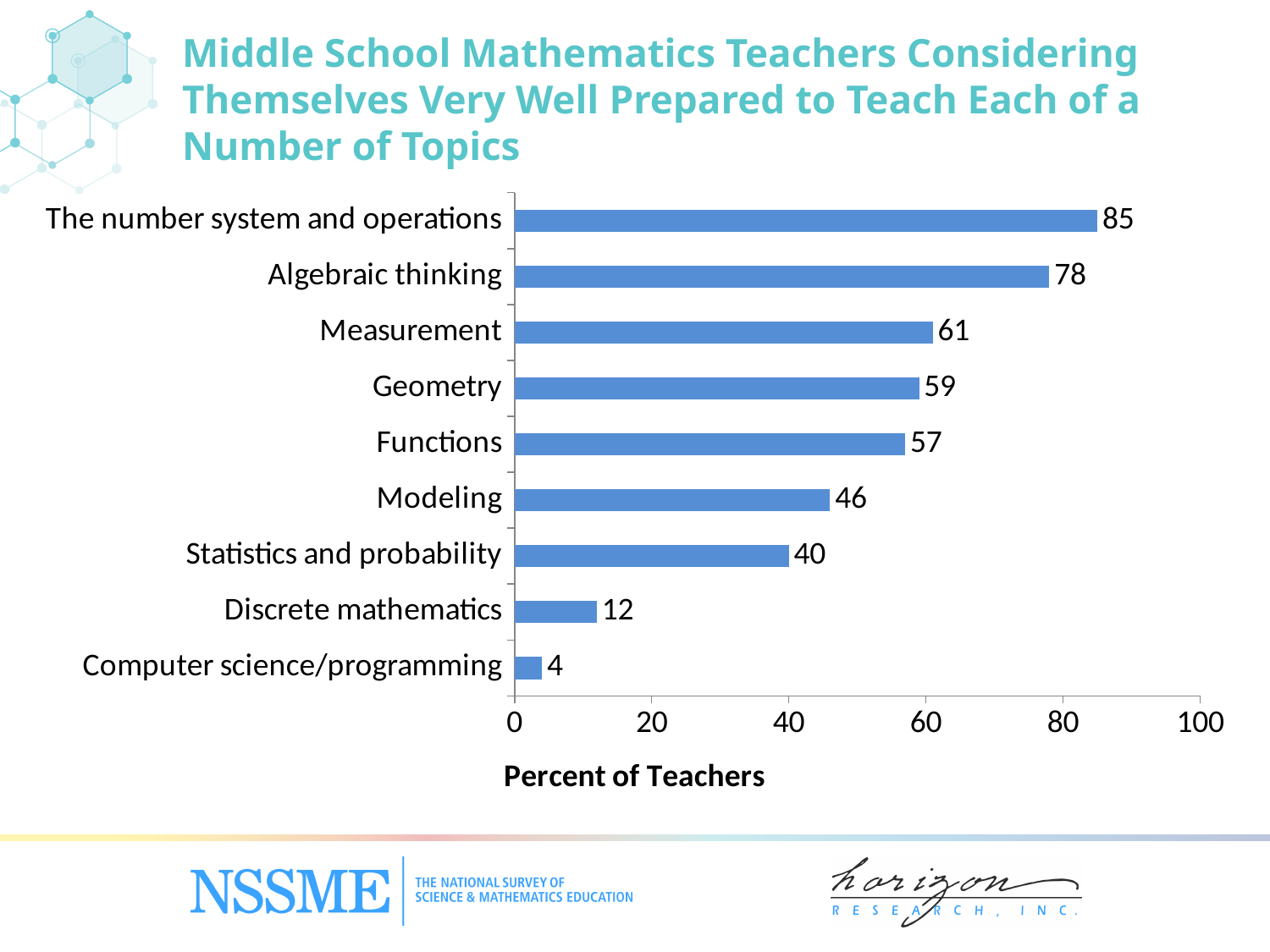
Is the value for Algebraic thinking greater or less than 60? greater What percent of teachers consider themselves very well prepared to teach Algebraic thinking? 78 Which topic has the highest percent of teachers? The number system and operations What is the value shown for Statistics and probability? 40 What kind of chart is shown on the slide? Bar chart How many topics are shown in the chart? 9 What is the difference between the values for Measurement and Geometry? 2 Which topic has the lowest percent of teachers? Computer science/programming What is the difference between the values for The number system and operations and Modeling? 39 What is the value shown for Discrete mathematics? 12 Which has a larger value, Functions or Modeling? Functions What is the label of the horizontal axis? Percent of Teachers